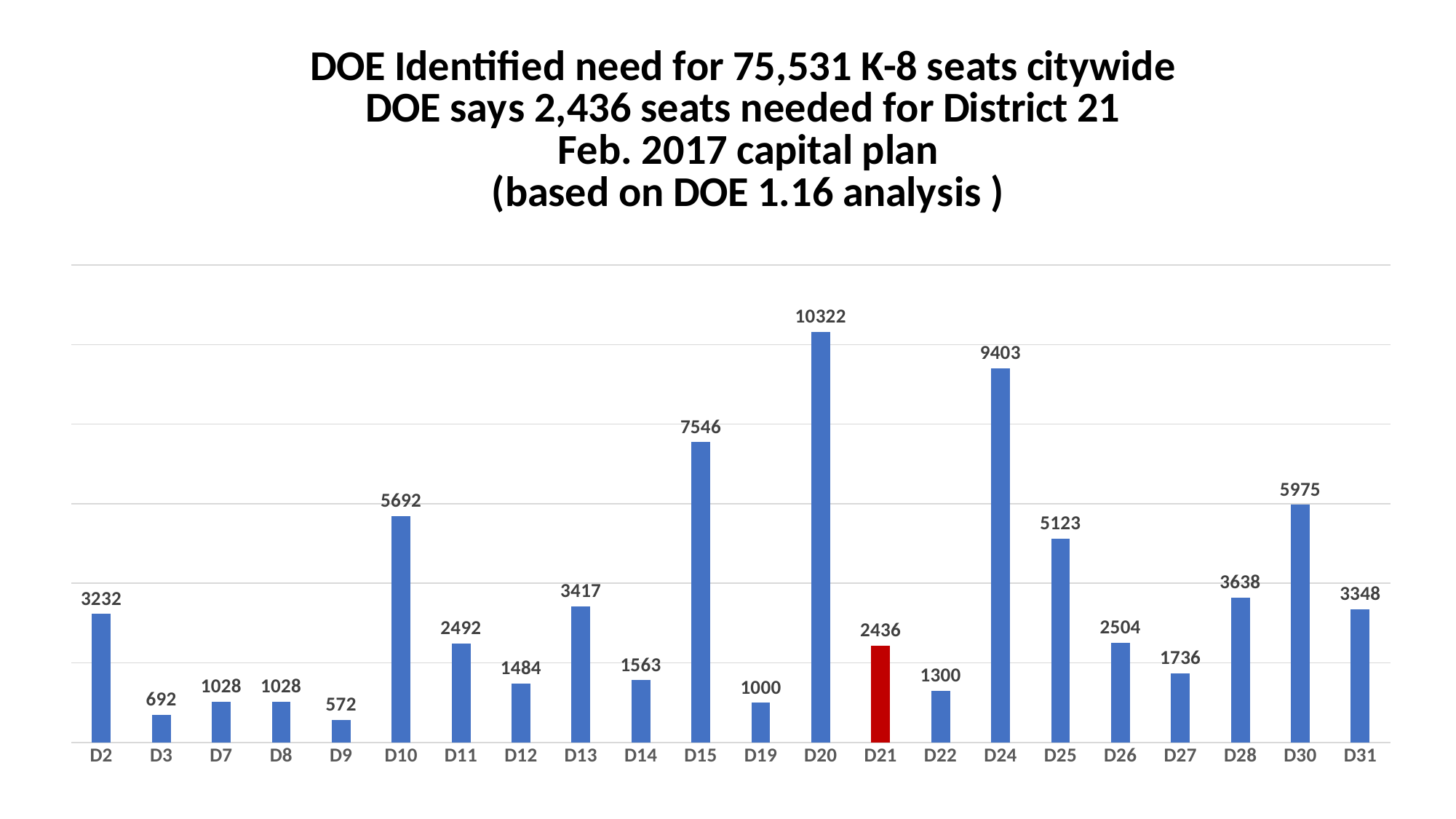
What is the value shown for D9? 572 Which is larger, the value for D13 or the value for D28? D28 Which district has the lowest value? D9 What is the difference between the values for D10 and D21? 3256 Which district's bar is coloured red instead of blue? D21 What is the value shown for D15? 7546 Which is larger, the value for D30 or the value for D25? D30 What is the value shown for D21? 2436 What is the difference between the values for D20 and D24? 919 What kind of chart is shown on the slide? bar chart How many districts are shown on the x axis? 22 Which district has the highest value? D20